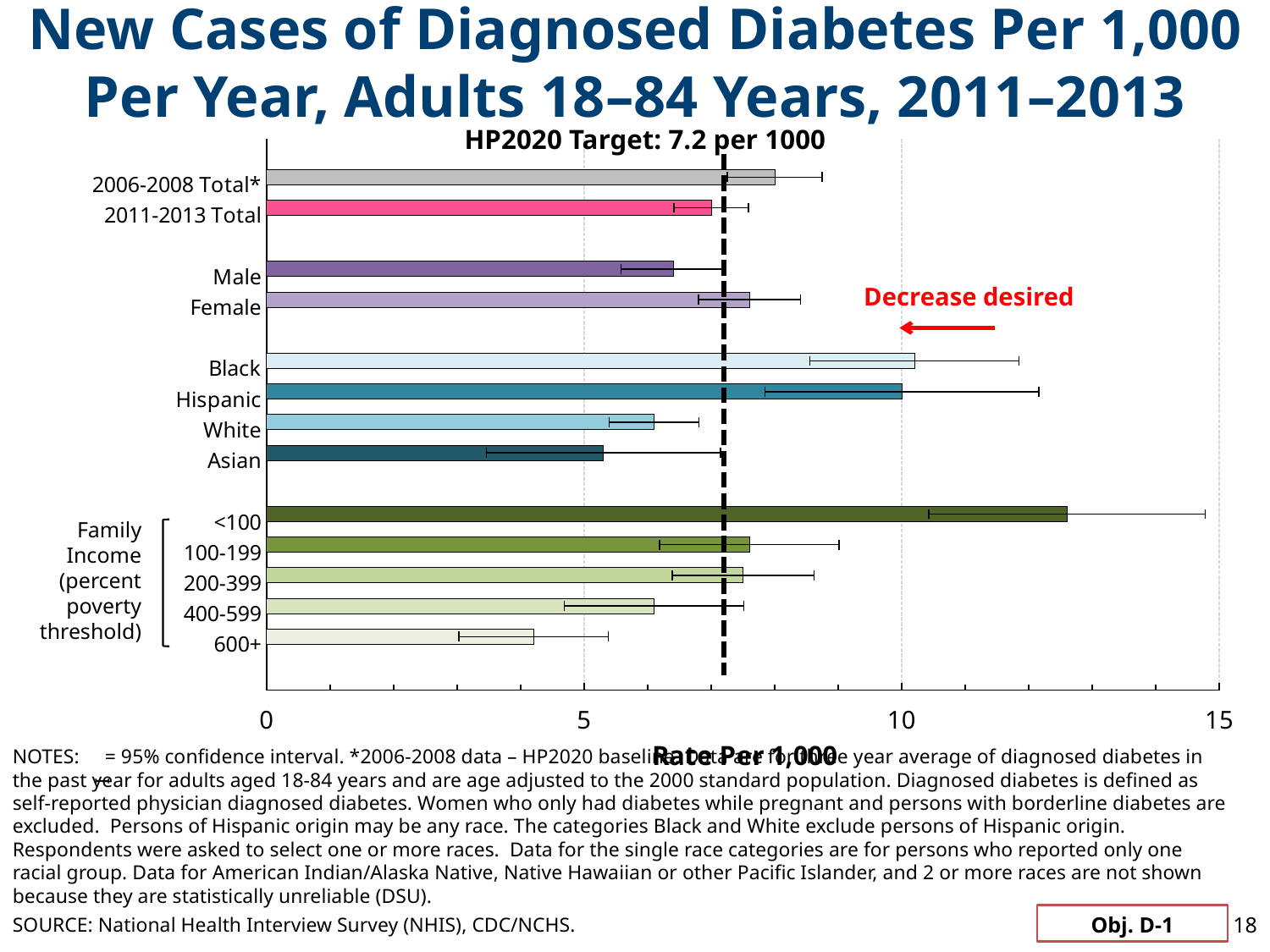
Which has a higher rate, Hispanic adults or Asian adults? Hispanic Which category has the lowest rate of new diagnosed diabetes cases? 600+ (family income, percent poverty threshold) Is the value for White adults greater or less than 5? greater How many bars (categories) are plotted in the chart? 13 Which category has the highest rate of new diagnosed diabetes cases? <100 (family income, percent poverty threshold) Is the value for Female adults greater or less than 10? less What is the label of the x axis? Rate Per 1,000 Is the value for the <100 family income group greater or less than 10? greater Which has a higher rate, Black adults or White adults? Black What is the HP2020 target rate shown on the chart? 7.2 per 1000 What kind of chart is shown on the slide? Bar chart